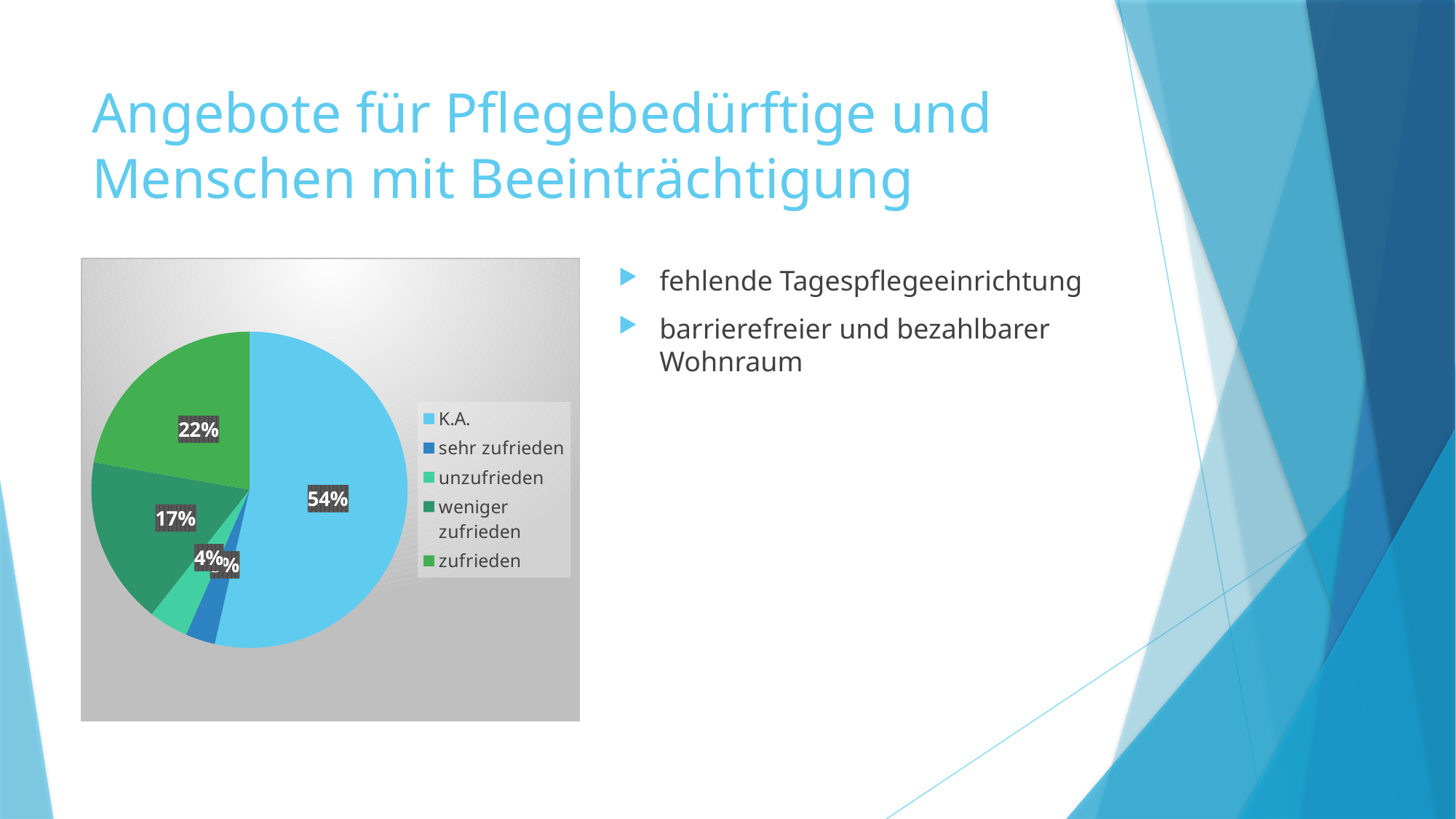
Which legend entry is shown in light blue in the pie chart? K.A. Which slice is larger in the pie chart, K.A. or unzufrieden? K.A. What type of chart is shown on the slide? pie chart What percentage of the pie chart is labelled K.A.? 54% Which category has the largest slice in the pie chart? K.A. Which slice is larger in the pie chart, zufrieden or weniger zufrieden? zufrieden What share of the pie chart does the zufrieden slice have? 22% How many categories does the pie chart show? 5 What is the combined share of the zufrieden and weniger zufrieden slices? 39% How many percentage points larger is the K.A. slice than the zufrieden slice? 32 What percentage is shown for unzufrieden in the pie chart? 4% What value is shown for weniger zufrieden in the pie chart? 17%